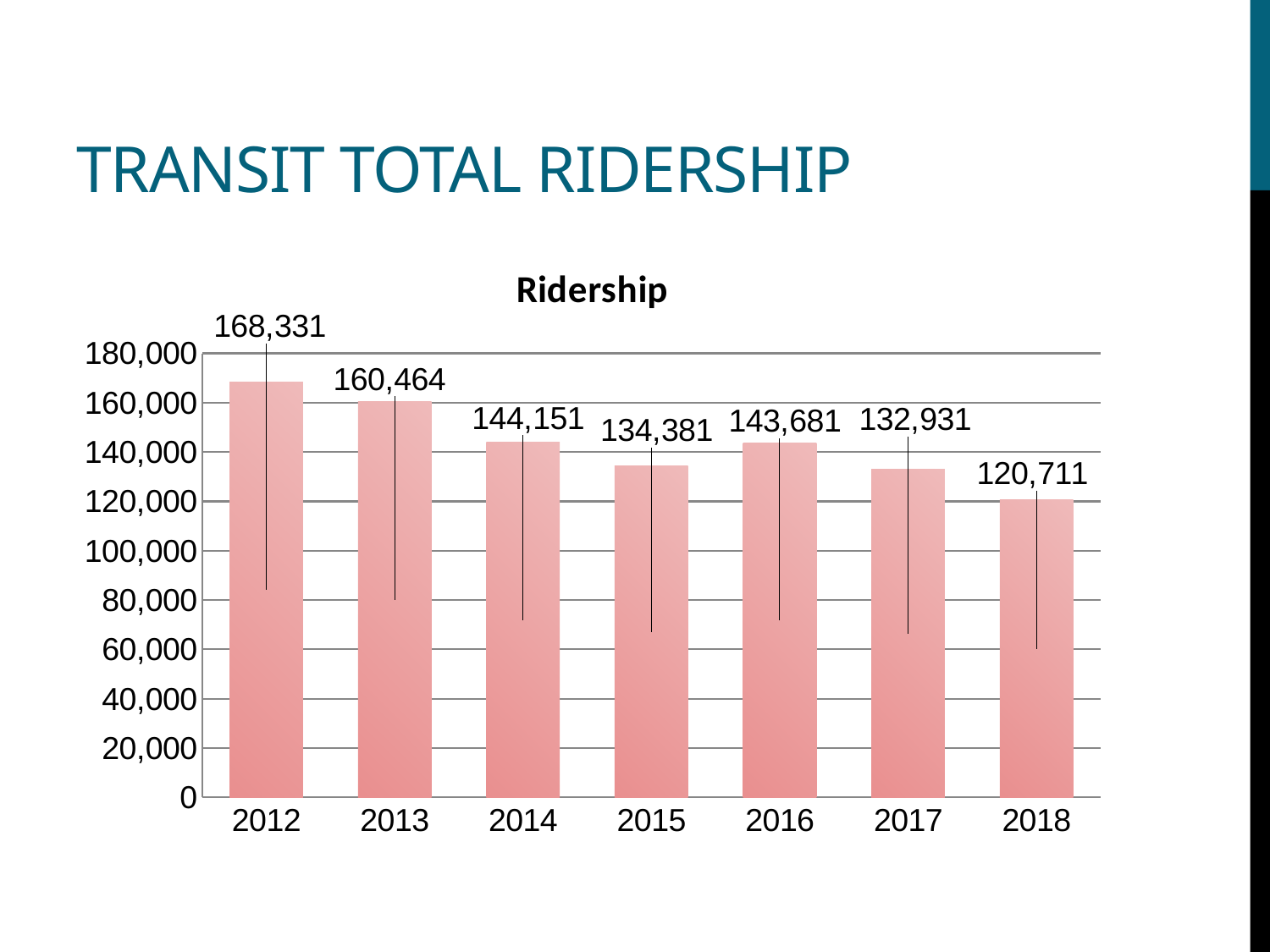
Is the ridership value for 2017 greater or less than 140,000? less What is the difference in ridership between 2013 and 2014? 16,313 What is the ridership value for 2018? 120,711 Which year has the highest ridership? 2012 What is the difference in ridership between 2012 and 2018? 47,620 What is the ridership value for 2015? 134,381 What is the title of the chart? Ridership How many years are shown on the chart? 7 What is the ridership value for 2012? 168,331 What kind of chart is shown on the slide? bar chart Which year has the lowest ridership? 2018 Which year has higher ridership, 2015 or 2016? 2016